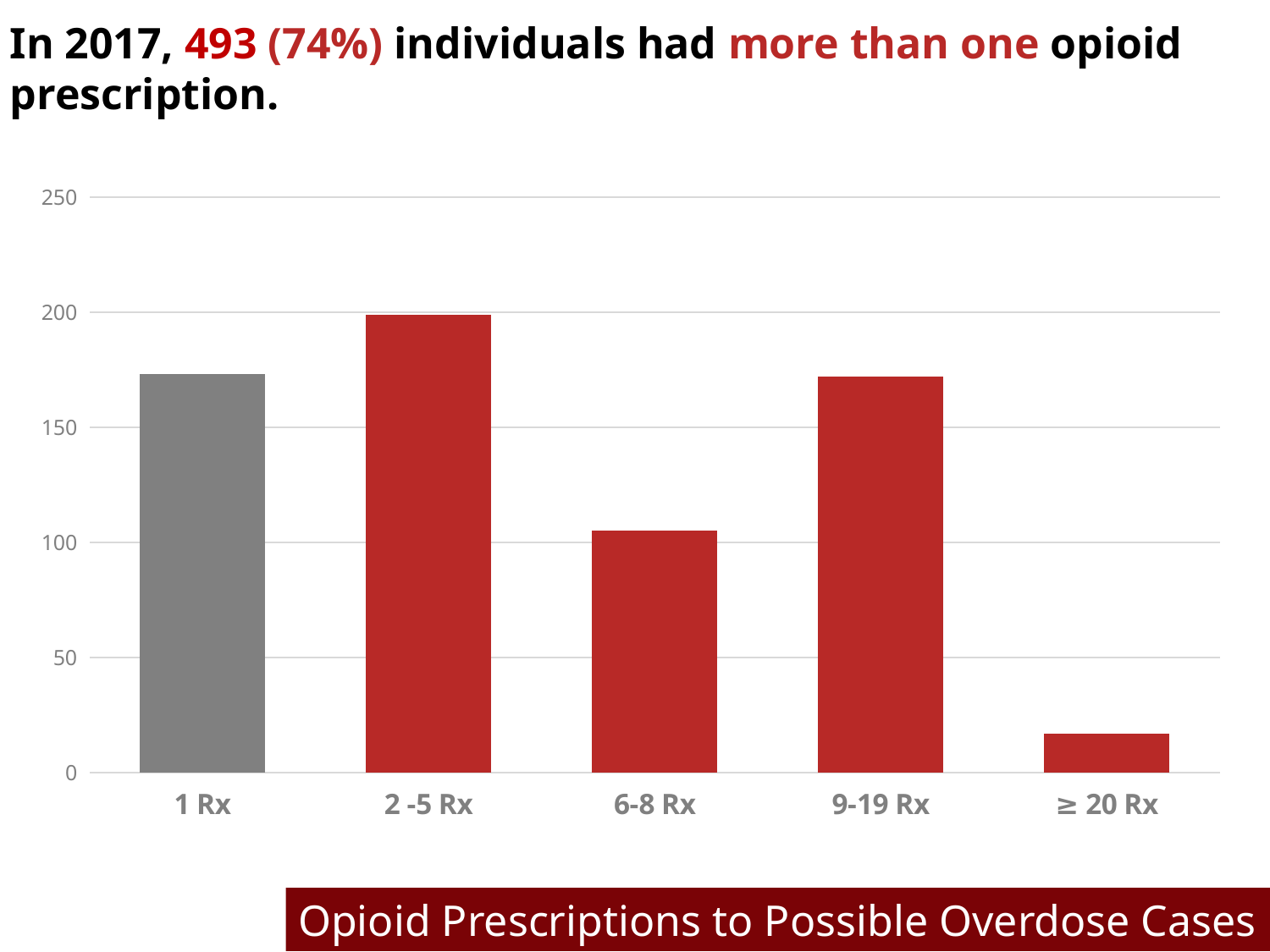
Is the value for ≥ 20 Rx greater or less than 50? less Is the value for 9-19 Rx greater or less than 200? less Is the value for 1 Rx greater or less than 150? greater How many prescription categories are shown on the x axis? 5 What kind of chart is shown on the slide? Bar chart Which is larger, the value for 9-19 Rx or the value for ≥ 20 Rx? 9-19 Rx Which category has the highest bar? 2 -5 Rx Which is larger, the value for 2 -5 Rx or the value for 6-8 Rx? 2 -5 Rx Which category has the lowest bar? ≥ 20 Rx What colour is the bar for 1 Rx? Grey